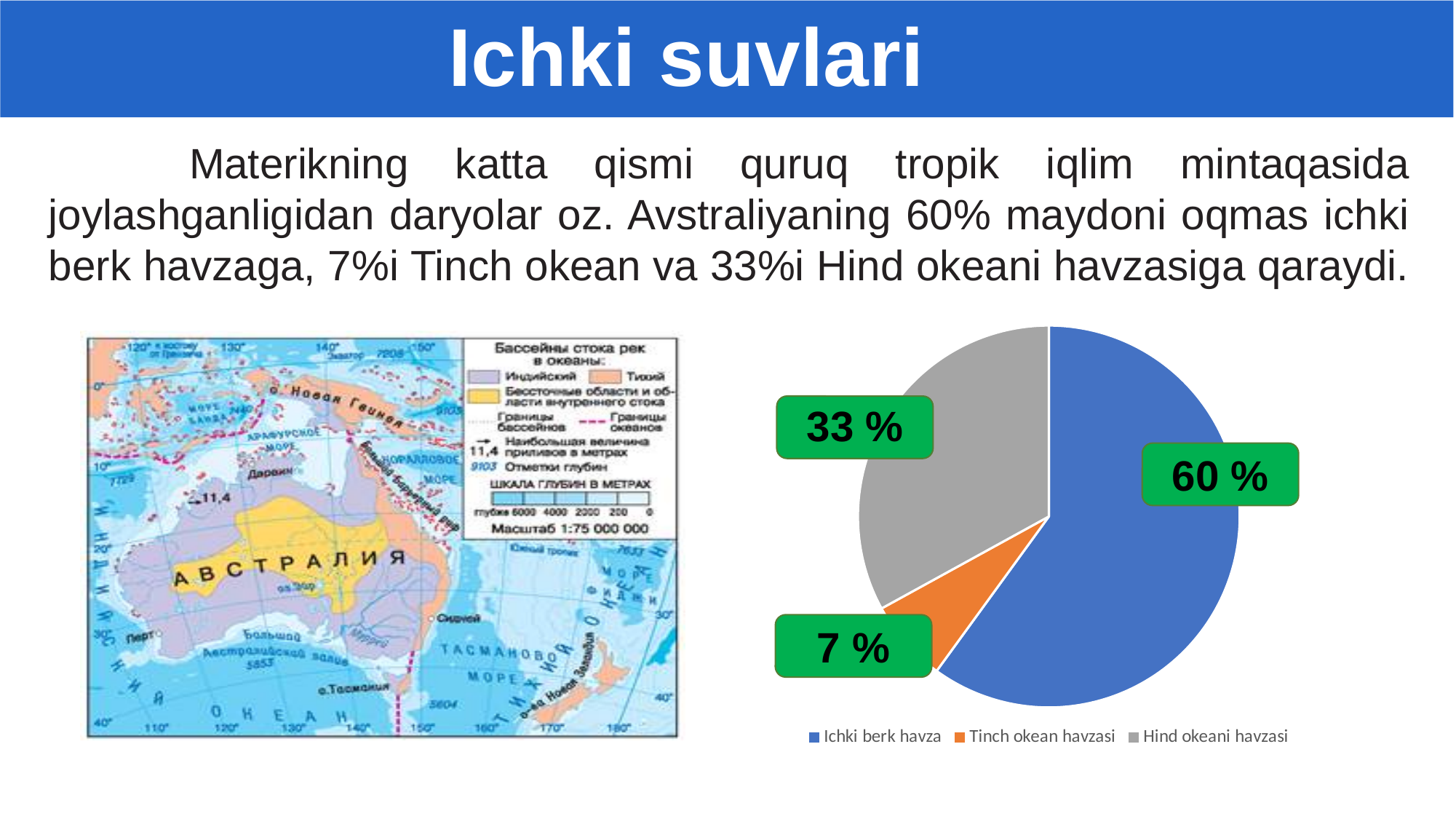
How many slices does the pie chart have? 3 What is the difference between the values for Hind okeani havzasi and Tinch okean havzasi in the pie chart? 26 % What is the value shown for Tinch okean havzasi in the pie chart? 7 % What is the value shown for Ichki berk havza in the pie chart? 60 % Which category has the largest slice in the pie chart? Ichki berk havza What is the value shown for Hind okeani havzasi in the pie chart? 33 % Which category has the smallest slice in the pie chart? Tinch okean havzasi How many entries does the legend of the pie chart list? 3 What colour is the slice for Tinch okean havzasi in the pie chart? orange What is the difference between the values for Ichki berk havza and Hind okeani havzasi in the pie chart? 27 % Which is larger in the pie chart, Hind okeani havzasi or Tinch okean havzasi? Hind okeani havzasi What kind of chart is shown on the right side of the slide? pie chart